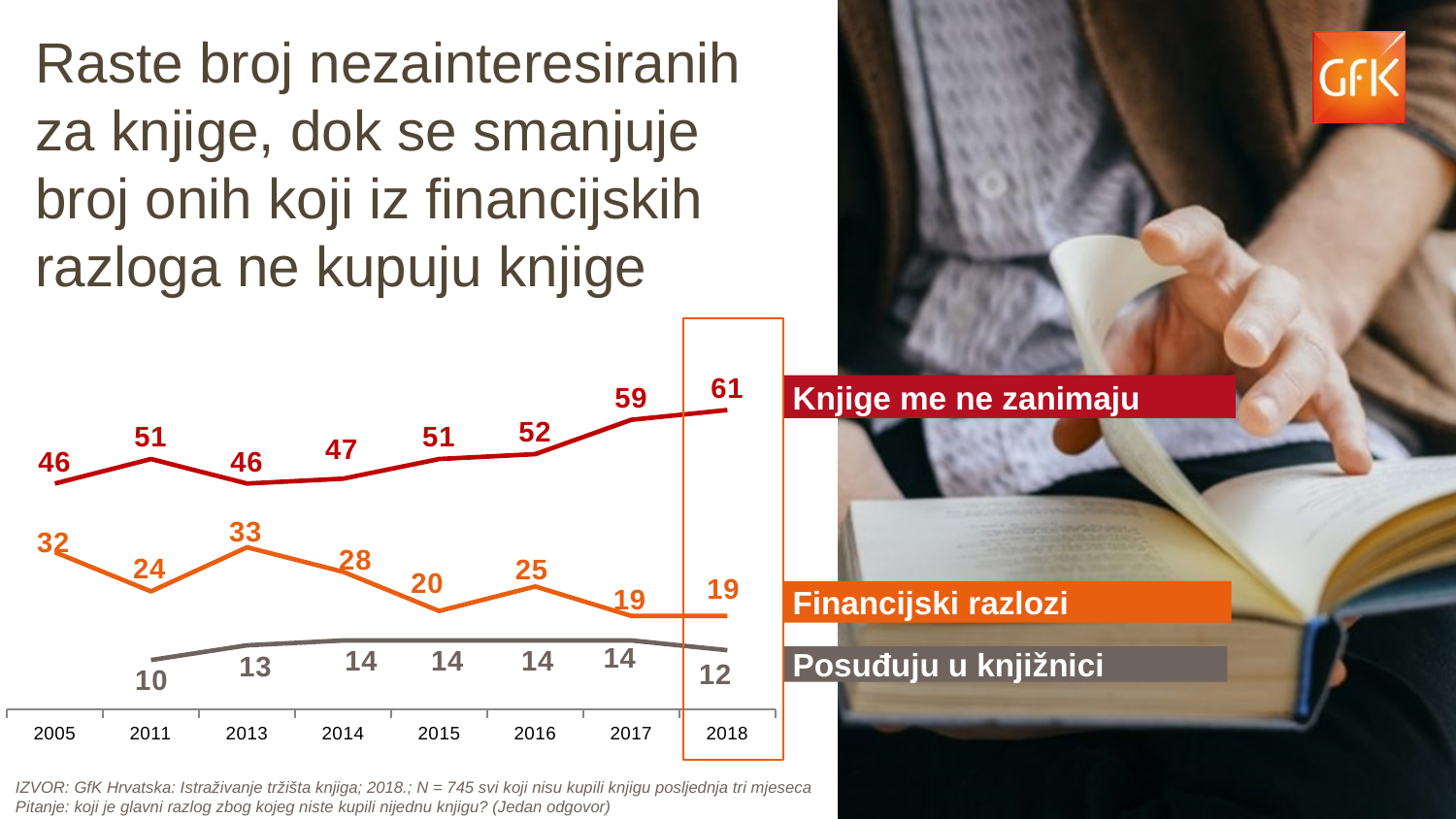
How many series does the chart show? 3 What is the value for "Knjige me ne zanimaju" in 2018? 61 What is the value for "Posuđuju u knjižnici" in 2011? 10 What is the value for "Financijski razlozi" in 2005? 32 Which is larger in 2013: the value for "Financijski razlozi" or the value for "Posuđuju u knjižnici"? Financijski razlozi In which year is the value for "Financijski razlozi" lowest? 2017 and 2018 Which series is drawn in orange? Financijski razlozi What is the difference between the "Knjige me ne zanimaju" values in 2018 and 2005? 15 In which year is the value for "Knjige me ne zanimaju" highest? 2018 What kind of chart is shown on the slide? Line chart How many years are shown on the x axis of the chart? 8 Does the value for "Knjige me ne zanimaju" rise or fall from 2016 to 2018? Rise